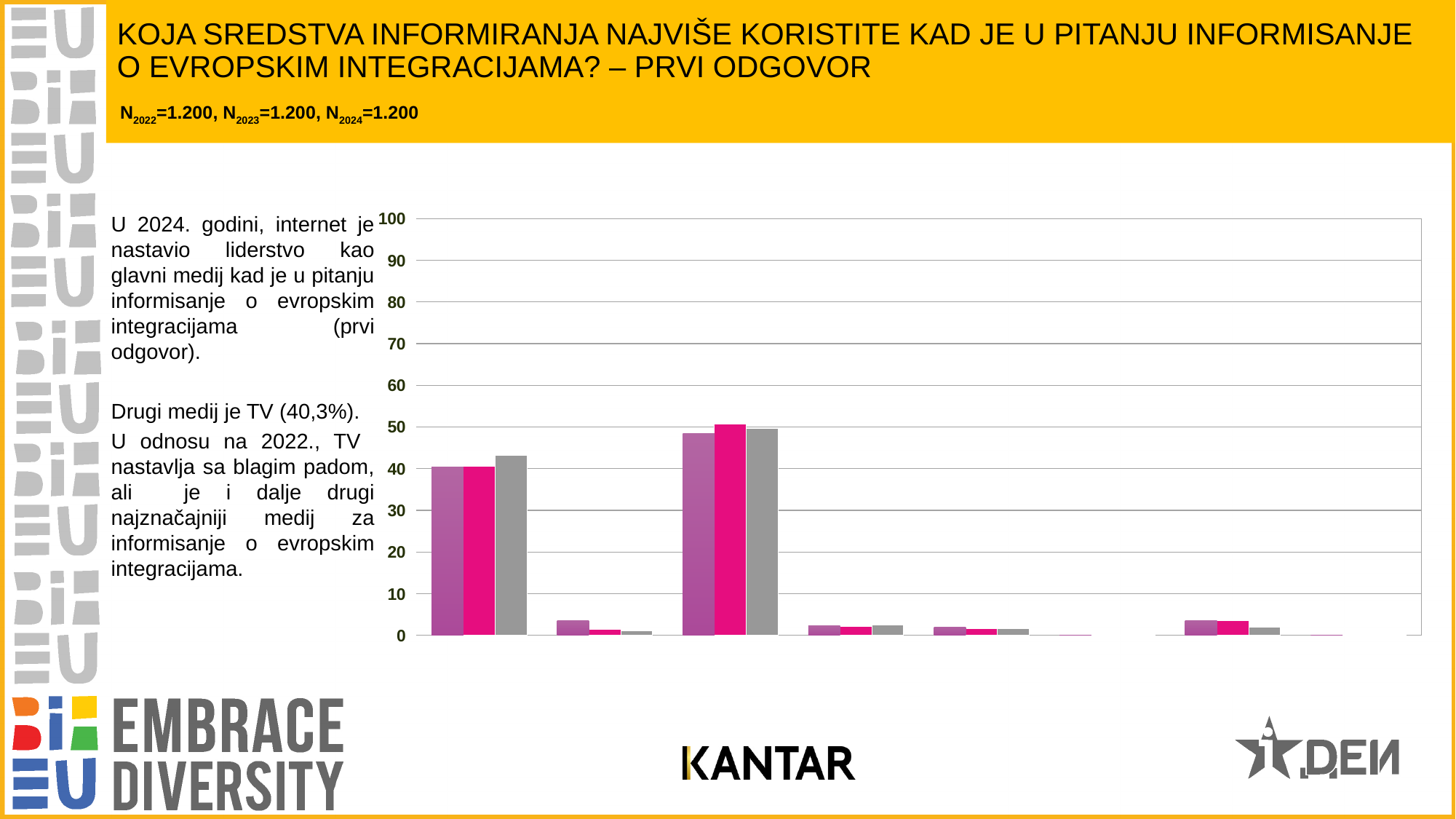
What is the highest value shown on the vertical axis of the chart? 100 How many bars are there in each group of bars in the chart? 3 Is the tallest bar in the chart greater or less than 40? greater Does the chart have a legend identifying the bar colours? No Is the tallest bar in the chart greater or less than 60? less What kind of chart is shown on the slide? bar chart